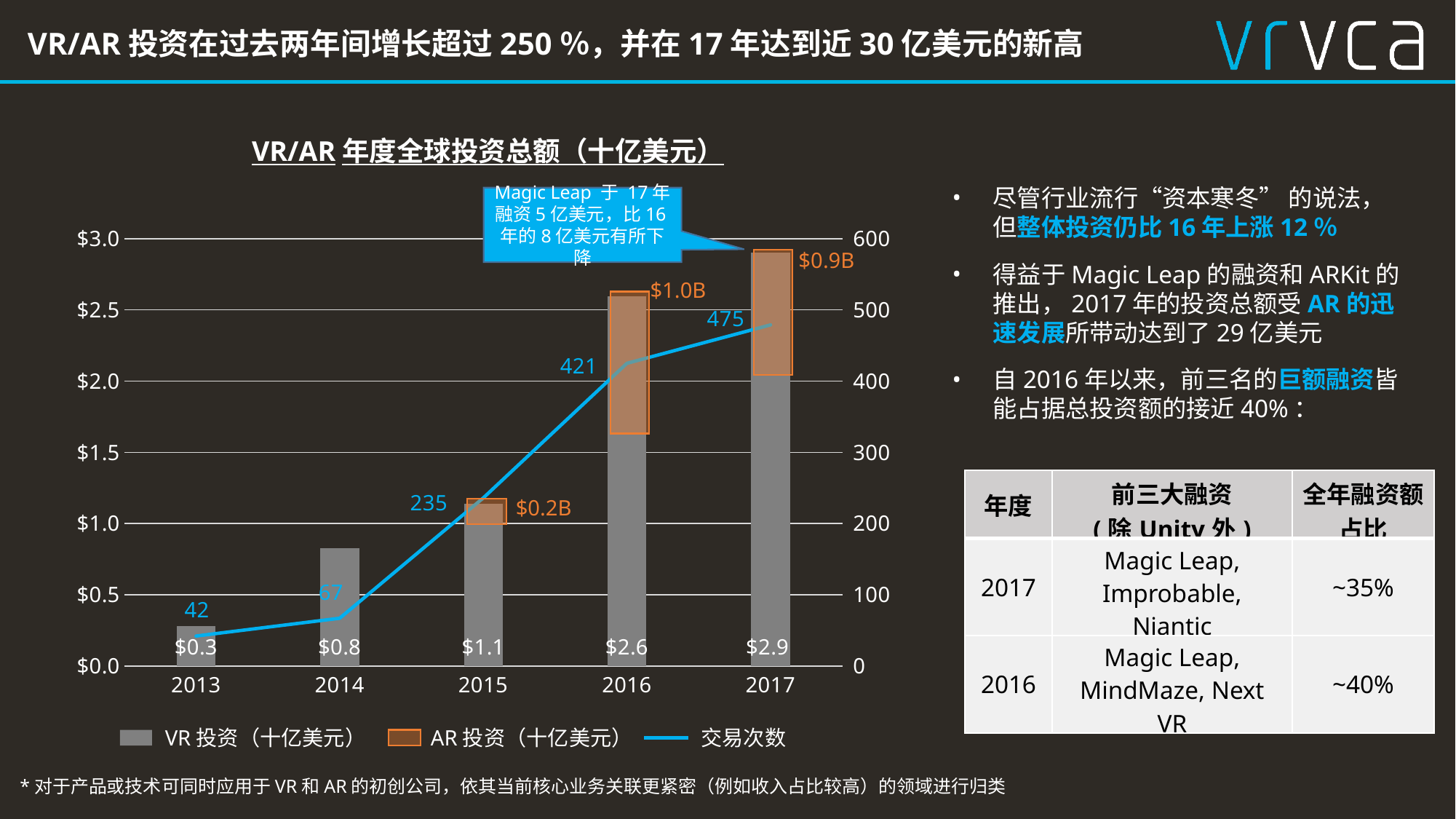
What total investment value is labelled on the 2016 bar? $2.6 What total investment value is labelled on the 2013 bar? $0.3 Which year has the lowest number of deals (交易次数)? 2013 By how much did the number of deals (交易次数) increase from 2016 to 2017? 54 How many deals (交易次数) does the line show for 2017? 475 Which year has the larger AR investment (AR 投资), 2016 or 2017? 2016 What is the AR investment (AR 投资) value labelled for 2017? $0.9B Does the number of deals (交易次数) rise or fall from 2013 to 2017? rise What is the AR investment (AR 投资) value labelled for 2016? $1.0B Which year has the highest number of deals (交易次数)? 2017 How many years are shown on the x axis of the chart? 5 How many series does the chart legend list? 3